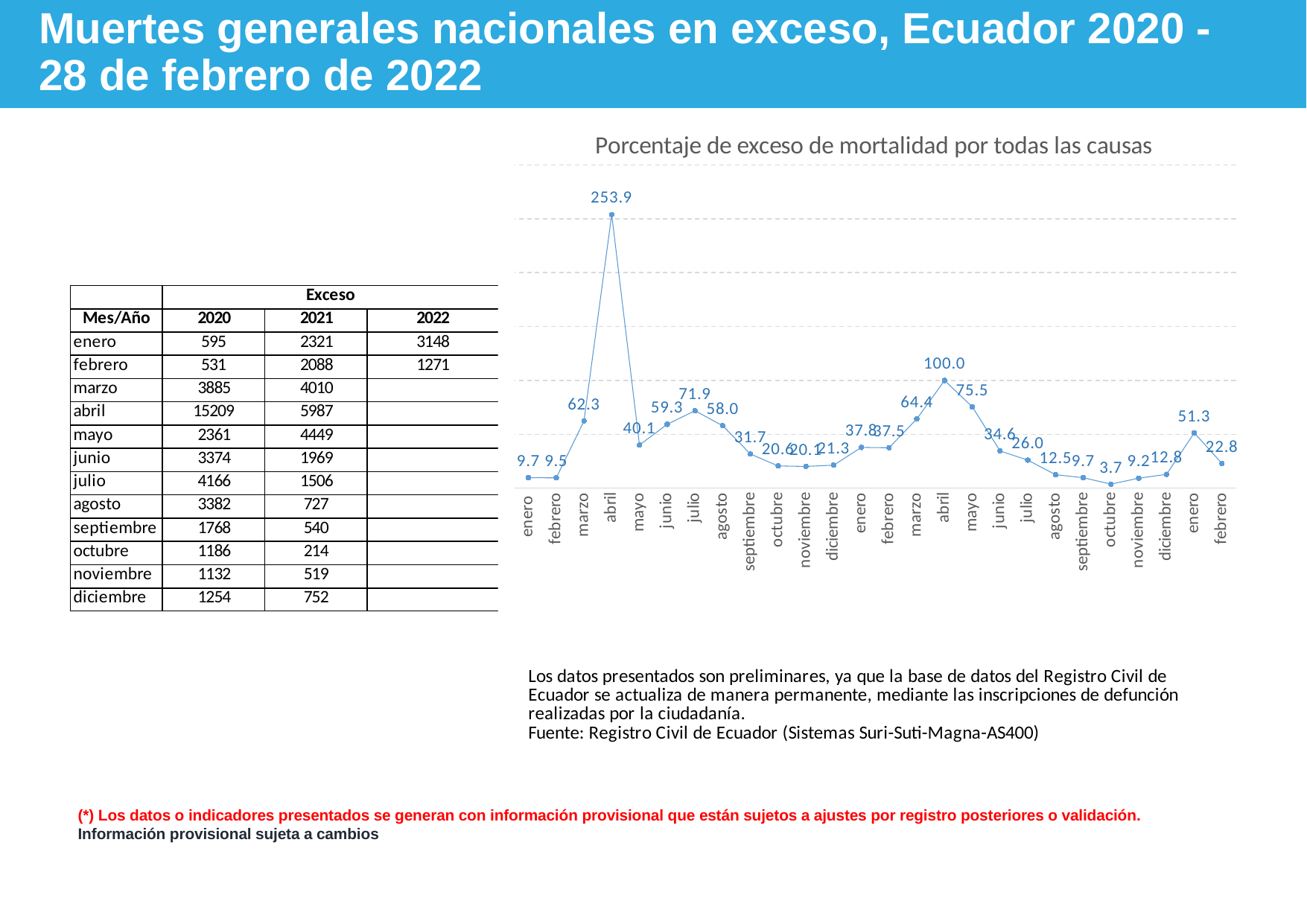
What is the difference between the first 'abril' value and the second 'abril' value? 153.9 Which point on the chart has the highest value? the first abril (253.9) Does the line rise or fall from the second 'abril' point to the second 'octubre' point? fall Which point on the chart has the lowest value? the second octubre (3.7) What is the value at the third 'enero' point on the chart? 51.3 What is the value at the second 'abril' point on the chart? 100.0 Which is larger: the value at the first 'julio' point or the value at the third 'enero' point? the first julio (71.9) What is the title of the chart? Porcentaje de exceso de mortalidad por todas las causas How many data points are plotted on the chart? 26 What kind of chart is shown on the slide? line chart What is the value at the last point on the chart (the final 'febrero')? 22.8 What is the value at the first 'abril' point on the chart? 253.9